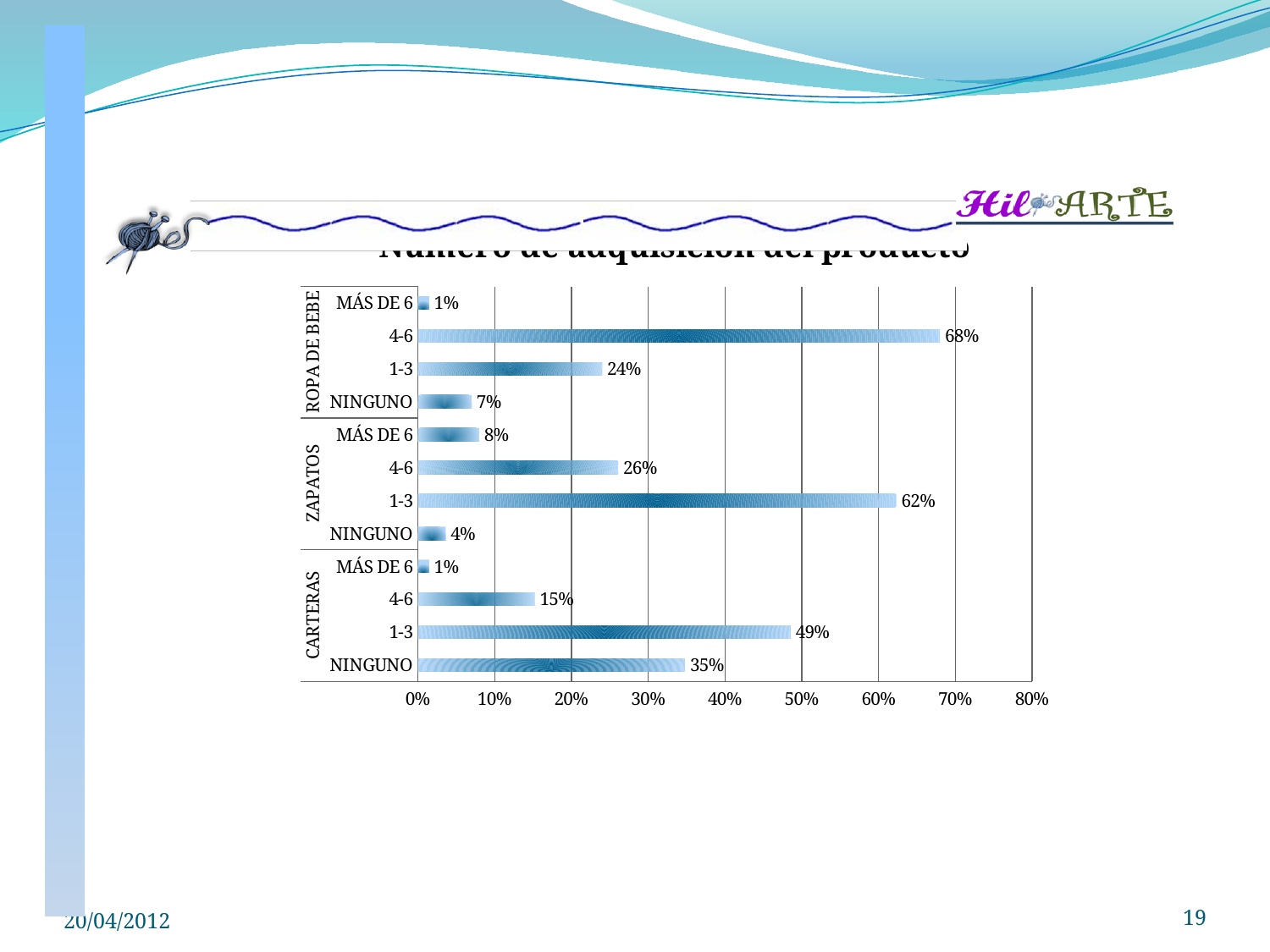
What is the value for 1-3 in the ZAPATOS group? 62% Which category has the lowest value in the ROPA DE BEBE group? MÁS DE 6 What kind of chart is shown on the slide? bar chart Which category has the highest value in the CARTERAS group? 1-3 What is the value for NINGUNO in the CARTERAS group? 35% What is the value for 4-6 in the ROPA DE BEBE group? 68% What is the value for MÁS DE 6 in the ZAPATOS group? 8% What is the difference between the 4-6 value for ROPA DE BEBE and the 4-6 value for ZAPATOS? 42% How many bars are plotted in the chart in total? 12 How many product groups are shown on the vertical axis? 3 Which is larger: the NINGUNO value for CARTERAS or the NINGUNO value for ZAPATOS? NINGUNO for CARTERAS What is the maximum value shown on the horizontal axis? 80%